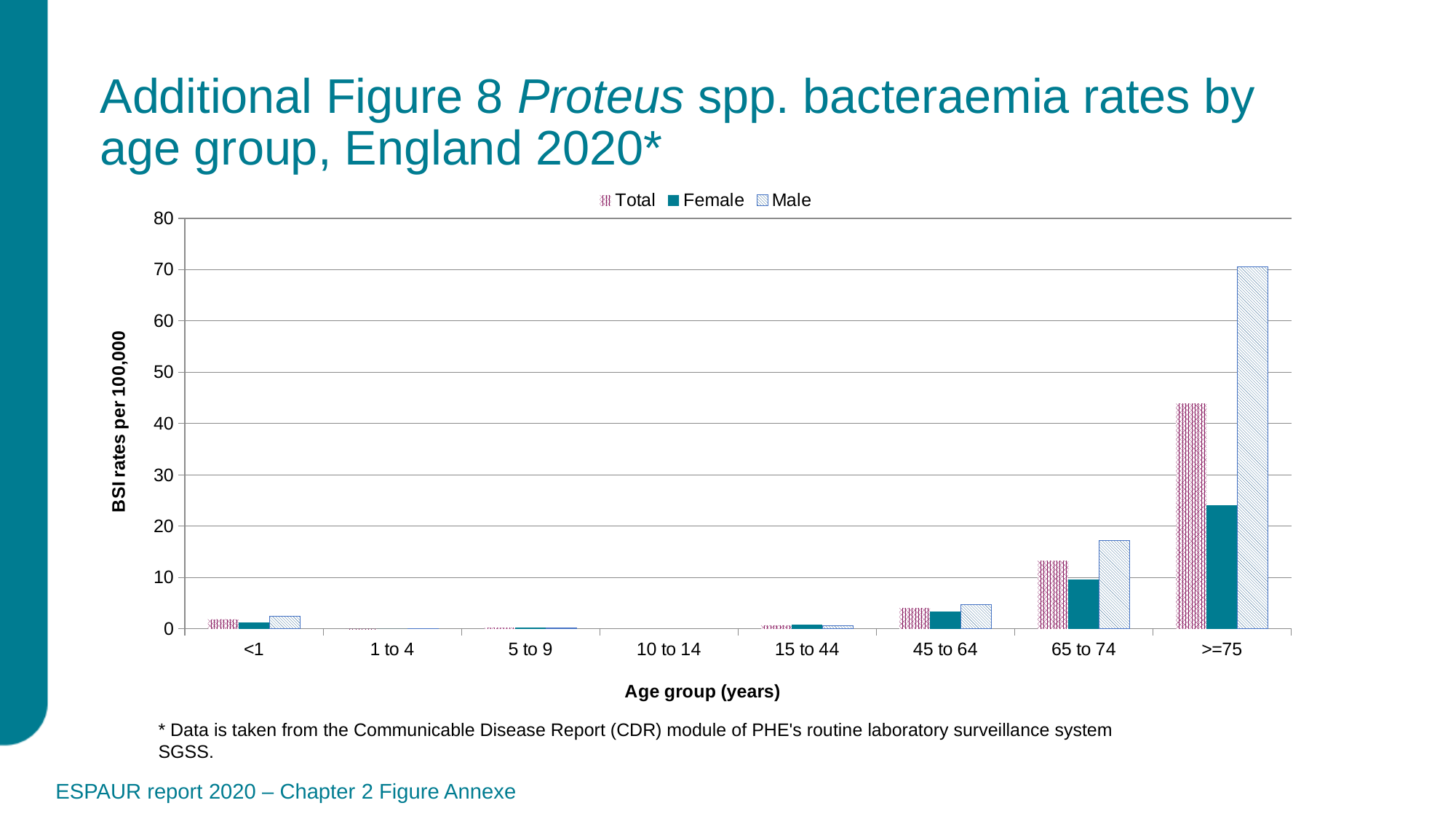
In the >=75 age group, which is larger, the Male rate or the Female rate? Male Is the Male value for the 65 to 74 age group greater or less than 10? greater What is the title of the y axis? BSI rates per 100,000 Is the Male value for the >=75 age group greater or less than 60? greater Do the Male rates rise or fall moving from the 45 to 64 age group to the >=75 age group? rise Which age group has the highest Total bacteraemia rate? >=75 Is the Total value for the >=75 age group greater or less than 40? greater What kind of chart is shown on the slide? bar chart How many age groups are shown on the x axis? 8 How many series does the legend list? 3 Which age group has the highest Male bacteraemia rate? >=75